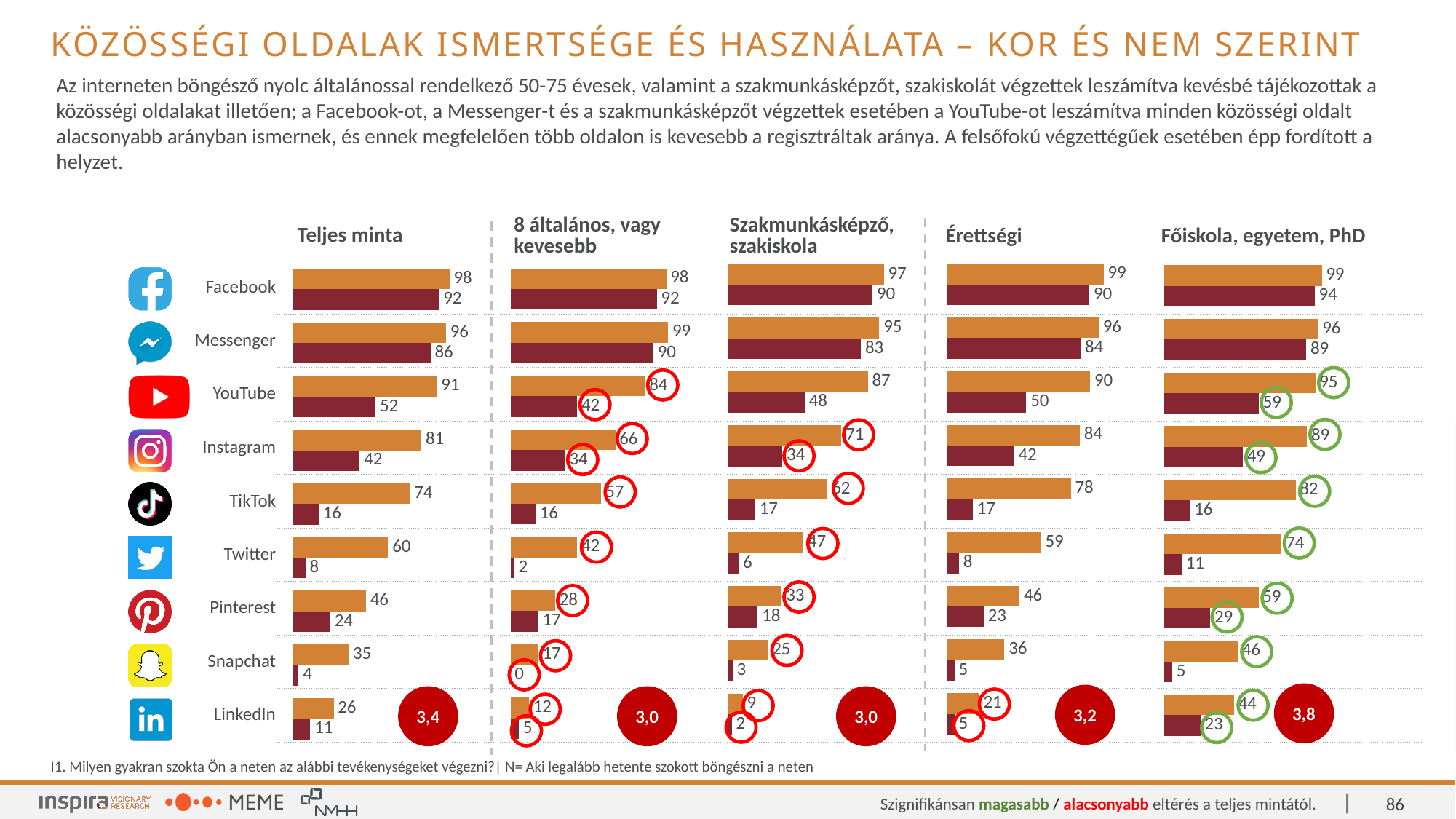
In the "Teljes minta" chart, what is the value of the dark red bar for YouTube? 52 In the "Teljes minta" chart, what is the difference between the orange and dark red bar values for Instagram? 39 In the "8 általános, vagy kevesebb" chart, what is the value of the dark red bar for Snapchat? 0 What number is shown in the red circle at the bottom of the "Főiskola, egyetem, PhD" chart? 3,8 In the "Főiskola, egyetem, PhD" chart, what is the difference between the orange bar values for YouTube and Twitter? 21 How many platforms (categories) are shown in the "Teljes minta" chart? 9 In the "Teljes minta" chart, what is the value of the orange bar for Facebook? 98 In the "Szakmunkásképző, szakiskola" chart, which platform has the lowest orange bar value? LinkedIn In the "Érettségi" chart, which platform has the highest orange bar value? Facebook What type of chart is used to show the values for each platform on this slide? Bar chart In the "Főiskola, egyetem, PhD" chart, what is the value of the orange bar for TikTok? 82 Is the orange bar value for Twitter larger in the "Érettségi" chart or in the "Főiskola, egyetem, PhD" chart? Főiskola, egyetem, PhD